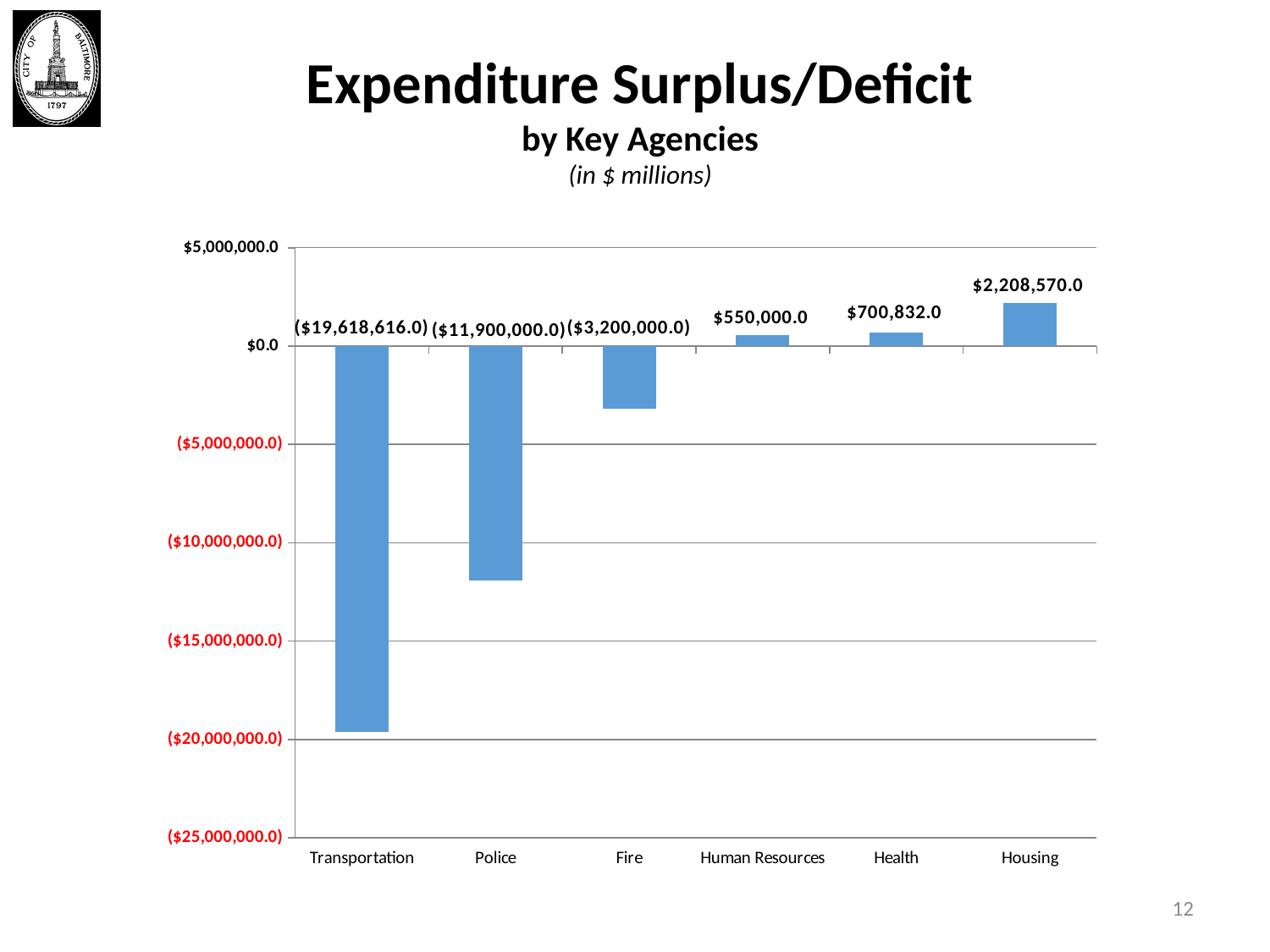
What is the difference between the values for Housing and Health? $1,507,738.0 Which agency has the highest value? Housing What kind of chart is shown on the slide? Bar chart What is the value for Fire? ($3,200,000.0) What is the value for Housing? $2,208,570.0 How many agencies are shown on the chart? 6 What is the title of the chart? Expenditure Surplus/Deficit by Key Agencies By how much does the deficit for Police exceed the deficit for Fire? $8,700,000.0 What is the value for Transportation? ($19,618,616.0) Which agency has the lowest value? Transportation Which is larger, the value for Health or the value for Human Resources? Health What is the value for Health? $700,832.0